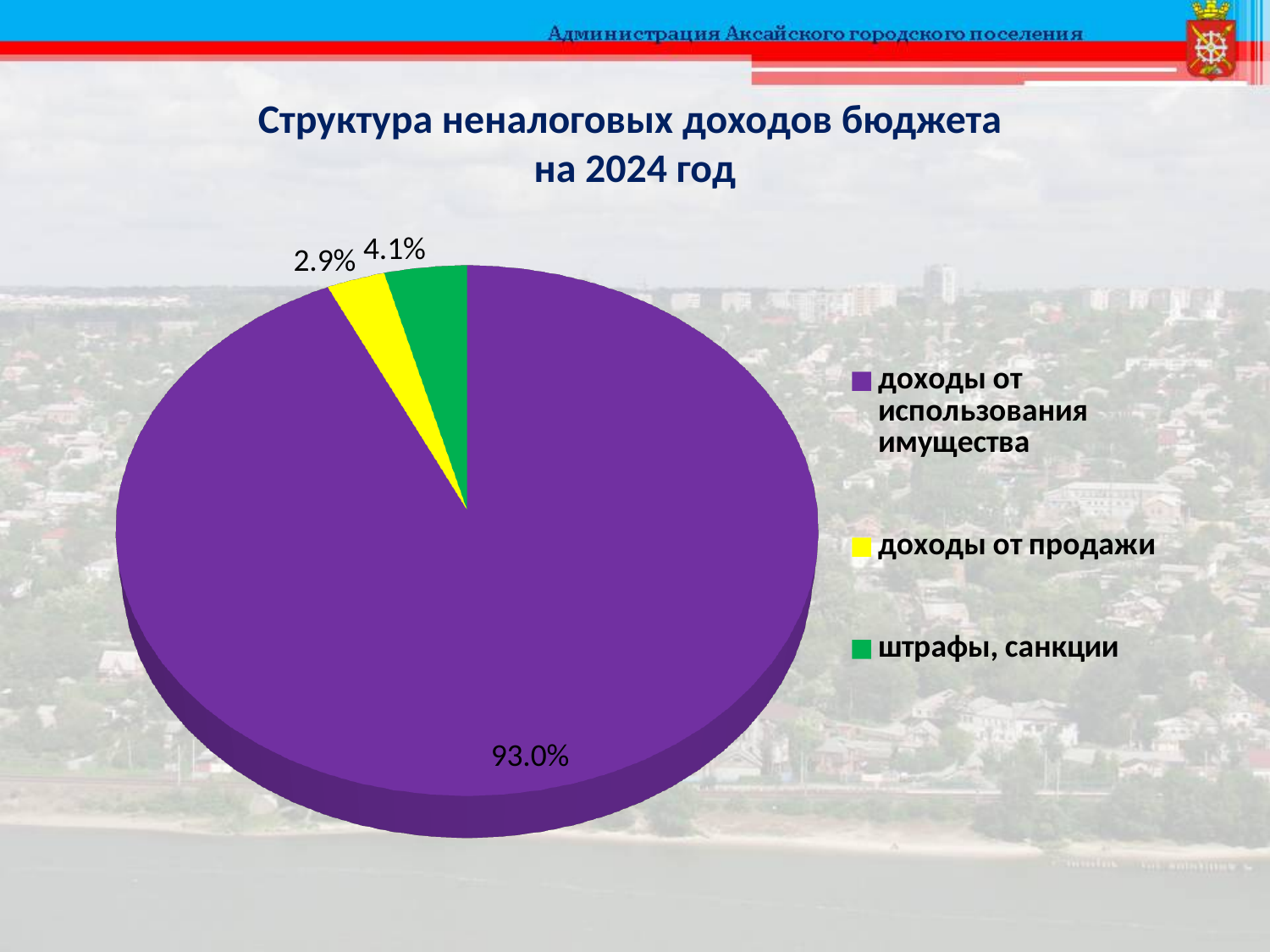
What share of the pie does 'штрафы, санкции' have? 4.1% What is the title of the chart? Структура неналоговых доходов бюджета на 2024 год Which category has the largest share of the pie? доходы от использования имущества What colour is the slice for 'доходы от продажи'? yellow Which is larger: the share of 'штрафы, санкции' or the share of 'доходы от продажи'? штрафы, санкции What is the difference between the shares of 'штрафы, санкции' and 'доходы от продажи'? 1.2% What kind of chart is shown on the slide? pie chart What share of the pie does 'доходы от продажи' have? 2.9% What share of the pie does 'доходы от использования имущества' have? 93.0% Which category has the smallest share of the pie? доходы от продажи How many entries does the legend list? 3 How many slices does the pie chart have? 3